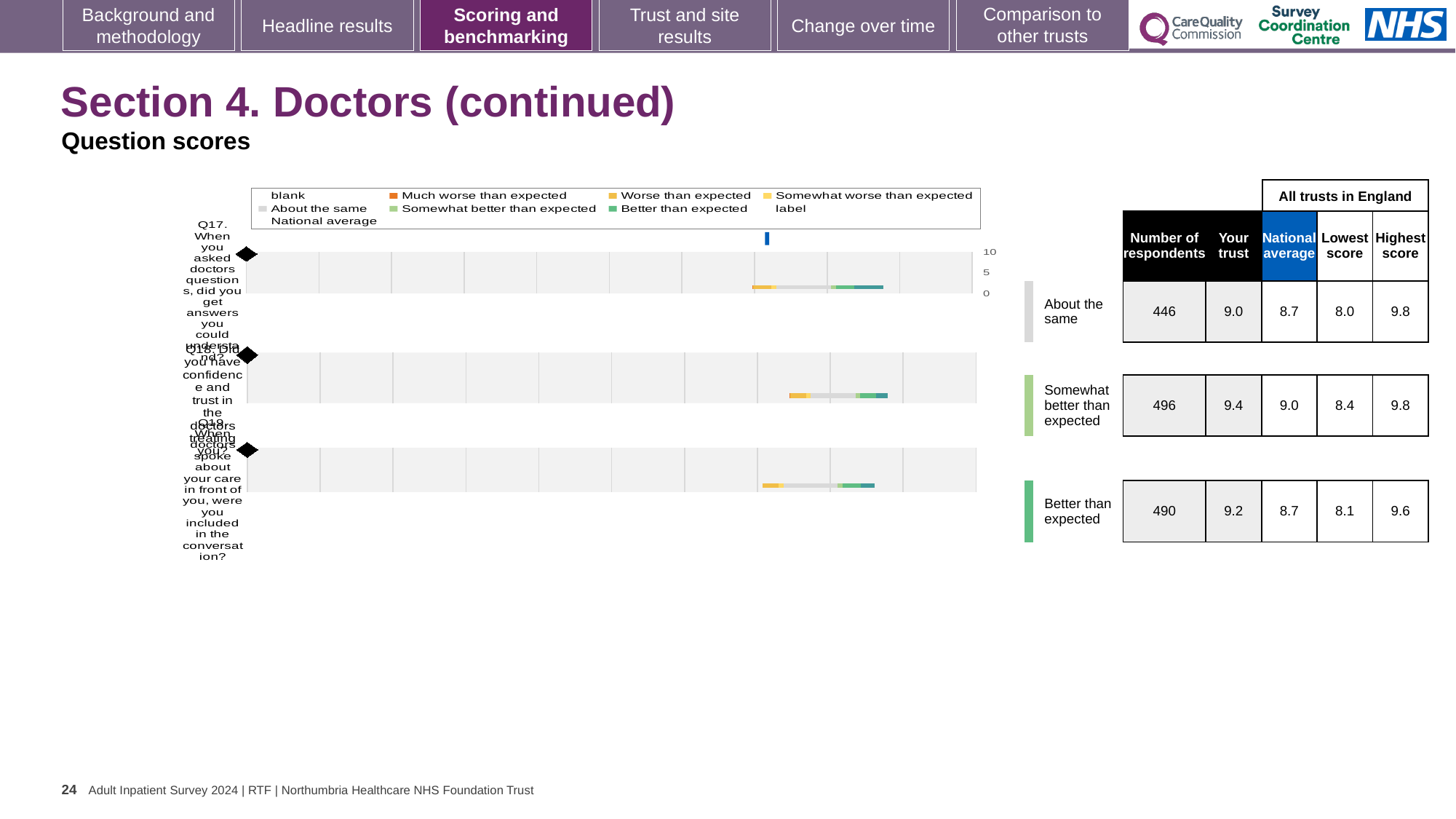
By how much does the 'Your trust' score for Q18 exceed its national average? 0.4 In the table, what is the number of respondents for Q17? 446 Which has the larger 'Your trust' score, Q17 or Q19? Q19 In the table, what is the 'Your trust' score for Q18? 9.4 Which question has the highest 'Your trust' score in the table? Q18 In the table, what is the highest score across all trusts in England for Q19? 9.6 What kind of chart is shown on the slide? bar chart In the table, what is the lowest score across all trusts in England for Q17? 8.0 Which question is rated 'Better than expected' in the benchmark chart? Q19 How many questions (bars) are plotted in the chart? 3 Which question has the lowest number of respondents in the table? Q17 Which benchmark category is shown for Q18 (confidence and trust in doctors)? Somewhat better than expected